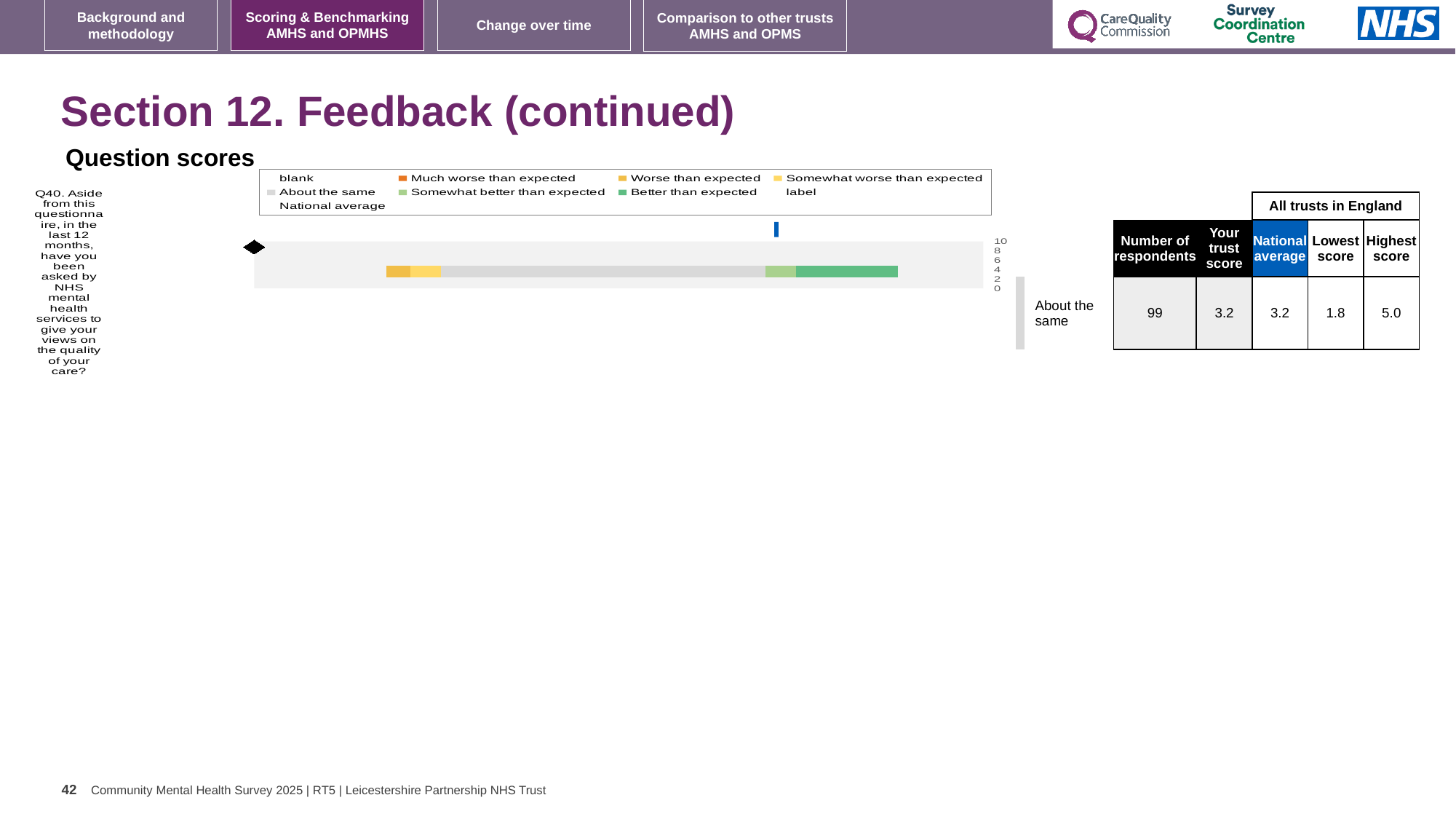
What kind of chart is shown under 'Question scores'? bar chart In the table beside the Question scores chart, what is 'Your trust score' for Q40? 3.2 In the table beside the Question scores chart, what is the Lowest score for Q40? 1.8 In the table beside the Question scores chart, what is the difference between the Highest score and the Lowest score for Q40? 3.2 What benchmark category is shown next to the Q40 bar in the Question scores chart? About the same In the table beside the Question scores chart, what is the number of respondents for Q40? 99 Which question is plotted in the Question scores chart? Q40 In the table beside the Question scores chart, is 'Your trust score' for Q40 larger than, smaller than, or equal to the National average? equal In the table beside the Question scores chart, what is the National average for Q40? 3.2 What is the highest tick value shown on the axis of the Question scores chart? 10 How many questions (categories) are plotted in the Question scores chart? 1 In the table beside the Question scores chart, what is the Highest score for Q40? 5.0